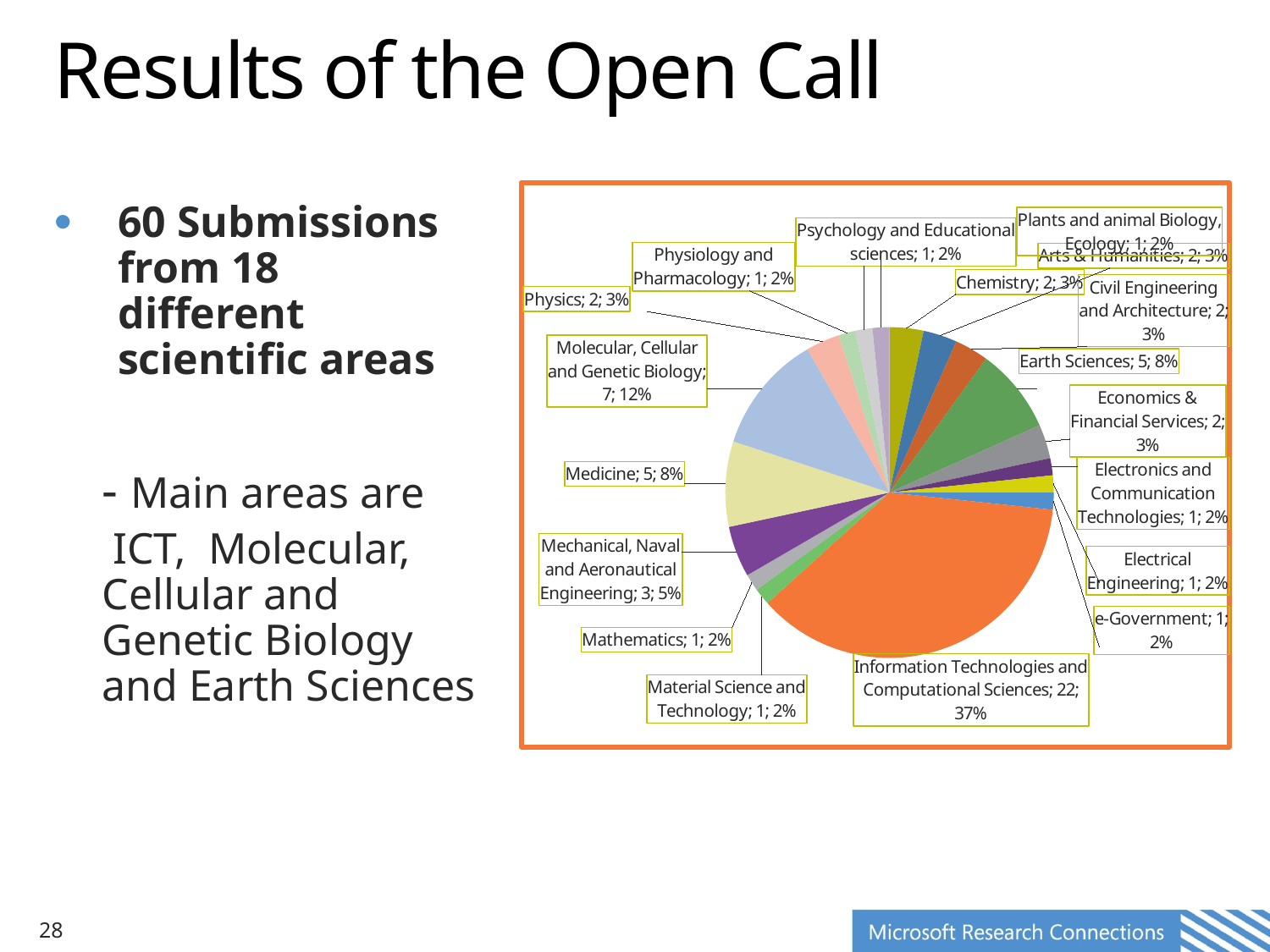
Which scientific area has the largest slice of the pie? Information Technologies and Computational Sciences How many submissions are shown for Chemistry? 2 How many submissions are shown for Mechanical, Naval and Aeronautical Engineering? 3 What share of the pie does Earth Sciences represent? 8% Which has more submissions, Earth Sciences or Physics? Earth Sciences How many submissions does the Information Technologies and Computational Sciences slice represent? 22 How many submissions are shown for Molecular, Cellular and Genetic Biology? 7 What kind of chart is shown on the slide? pie chart What is the difference in submissions between Information Technologies and Computational Sciences and Molecular, Cellular and Genetic Biology? 15 How many scientific areas (slices) are shown in the pie chart? 18 What percentage of the pie is Medicine? 8% What share of the pie does Information Technologies and Computational Sciences take? 37%